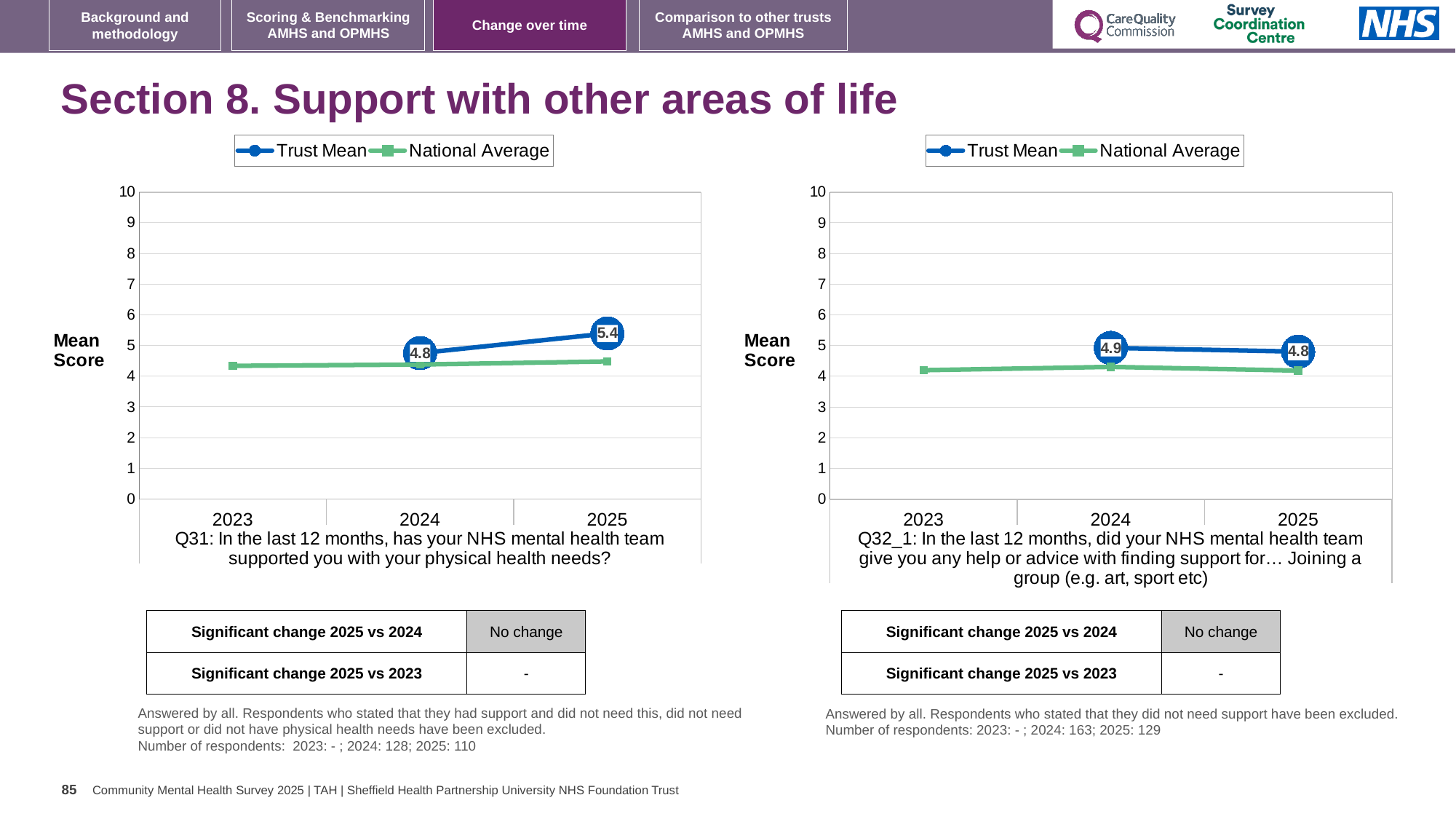
On the left chart (Q31), what is the Trust Mean for 2025? 5.4 On the right chart (Q32_1), what is the Trust Mean for 2024? 4.9 On the left chart (Q31), what is the Trust Mean for 2024? 4.8 On the left chart (Q31), by how much did the Trust Mean change from 2024 to 2025? 0.6 How many years are shown on the x axis of the left chart (Q31)? 3 How many series does the legend of the right chart (Q32_1) list? 2 On the left chart (Q31), is the National Average for 2023 greater or less than 5? less On the right chart (Q32_1), is the Trust Mean for 2025 greater or less than the National Average for 2025? greater What type of chart is used on the left (Q31)? line chart On the left chart (Q31), does the Trust Mean rise or fall from 2024 to 2025? rise On the right chart (Q32_1), what is the Trust Mean for 2025? 4.8 On the right chart (Q32_1), is the Trust Mean for 2024 higher or lower than the Trust Mean for 2025? higher